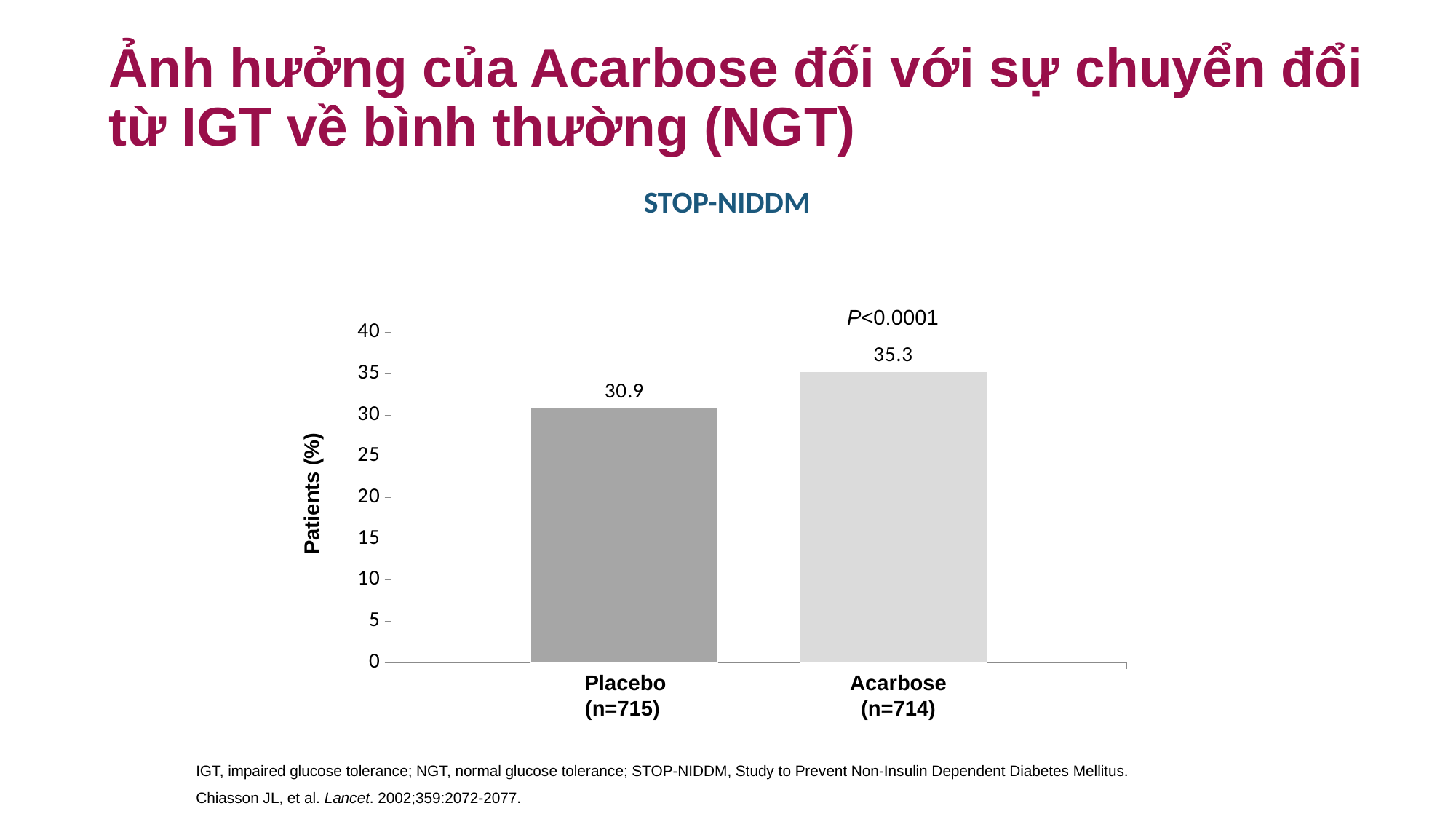
How many bars are shown in the chart? 2 What is the maximum value shown on the y axis? 40 What is the label of the y axis? Patients (%) Which group has the lower percentage of patients? Placebo (n=715) What kind of chart is shown on the slide? bar chart What is the difference between the Acarbose and Placebo values? 4.4 Is the value for Placebo greater or less than 35? less What is the value for Acarbose (n=714)? 35.3 Is the value for Acarbose greater or less than 30? greater Which group has the higher percentage of patients? Acarbose (n=714) What P value is shown above the Acarbose bar? P<0.0001 What is the value for Placebo (n=715)? 30.9